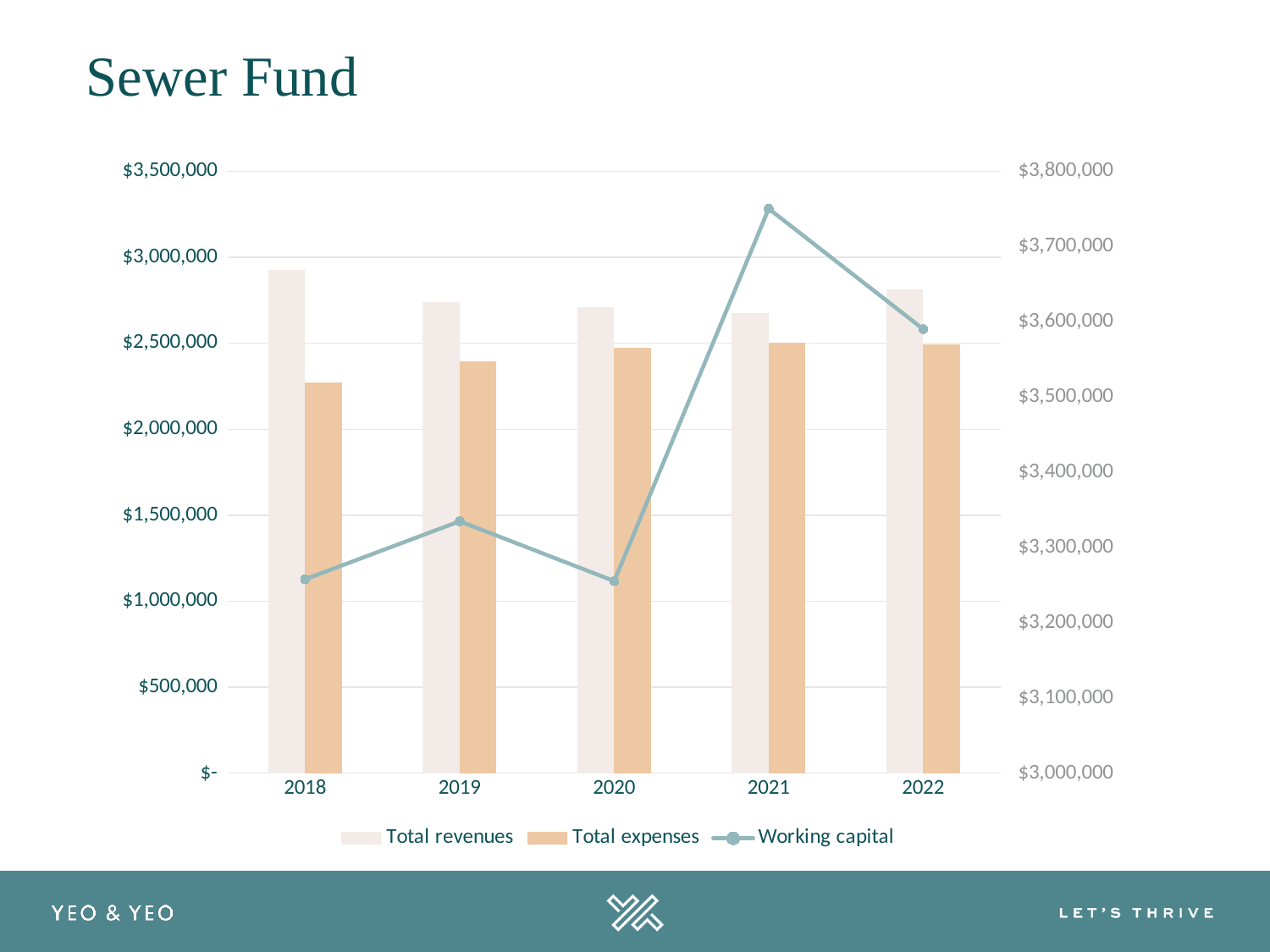
Which year has the highest Working capital? 2021 Is the Total revenues value for 2018 greater or less than $3,000,000? less What is the title of the slide containing the chart? Sewer Fund How many series does the legend list? 3 Is the Total expenses value for 2021 greater or less than $2,000,000? greater Is the Working capital value for 2021 greater or less than $3,700,000? greater Do Total expenses rise or fall from 2018 to 2021? rise Which year has the highest Total revenues? 2018 What kind of chart is shown on the slide? Combined bar and line chart In 2018, which is larger: Total revenues or Total expenses? Total revenues Which year has the lowest Total expenses? 2018 How many years are shown on the x axis of the chart? 5